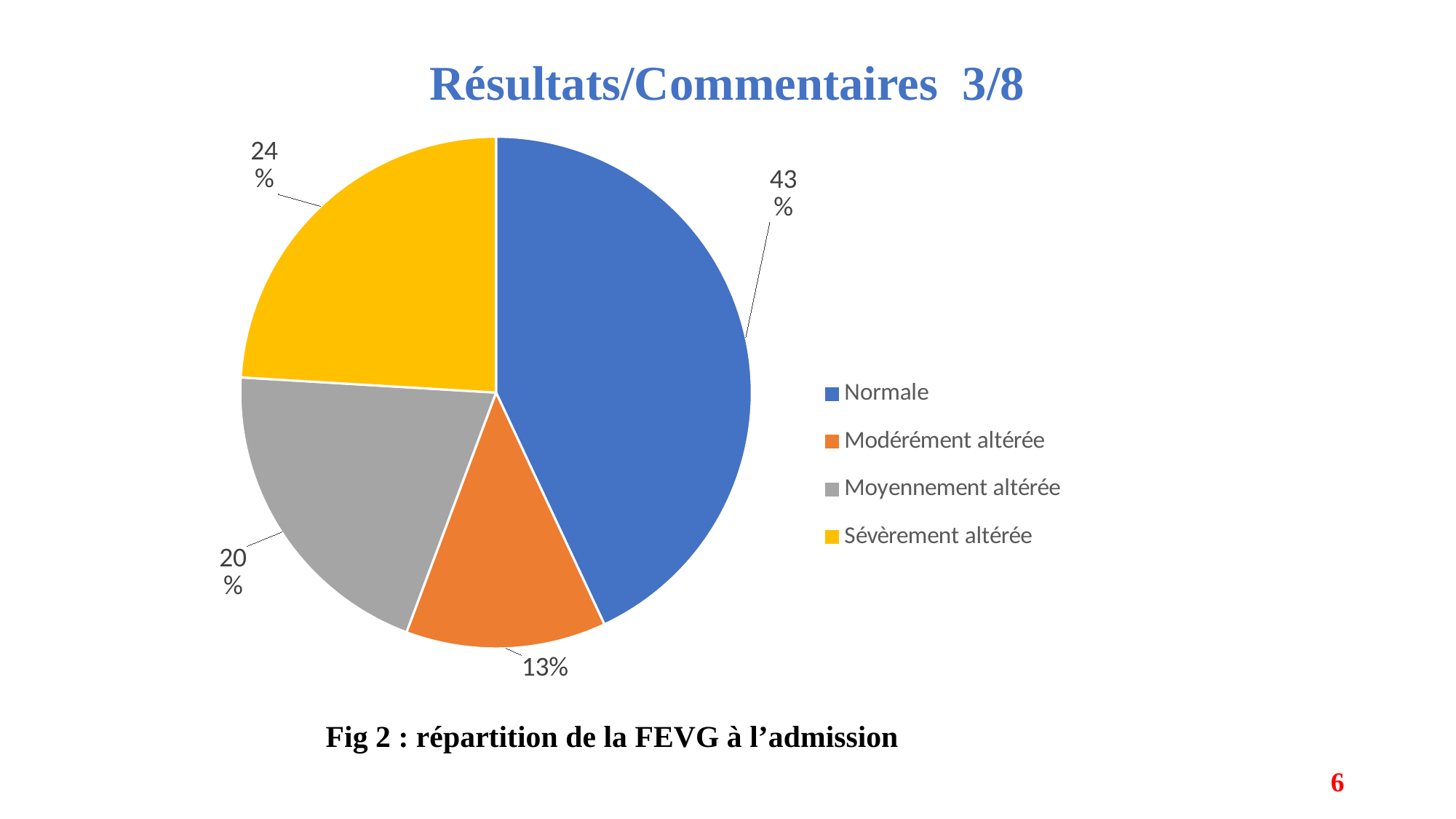
Which category has the smallest slice of the pie? Modérément altérée Which category has the largest slice of the pie? Normale What percentage of the pie is labelled for Normale? 43% What percentage of the pie is labelled for Modérément altérée? 13% What is the caption given below the chart? Fig 2 : répartition de la FEVG à l’admission What kind of chart is shown on the slide? pie chart Which slice is larger, Moyennement altérée or Sévèrement altérée? Sévèrement altérée What is the difference in percentage points between the Normale slice and the Sévèrement altérée slice? 19 How many slices does the pie chart have? 4 What percentage of the pie is labelled for Moyennement altérée? 20% What percentage of the pie is labelled for Sévèrement altérée? 24% How many entries does the legend list? 4